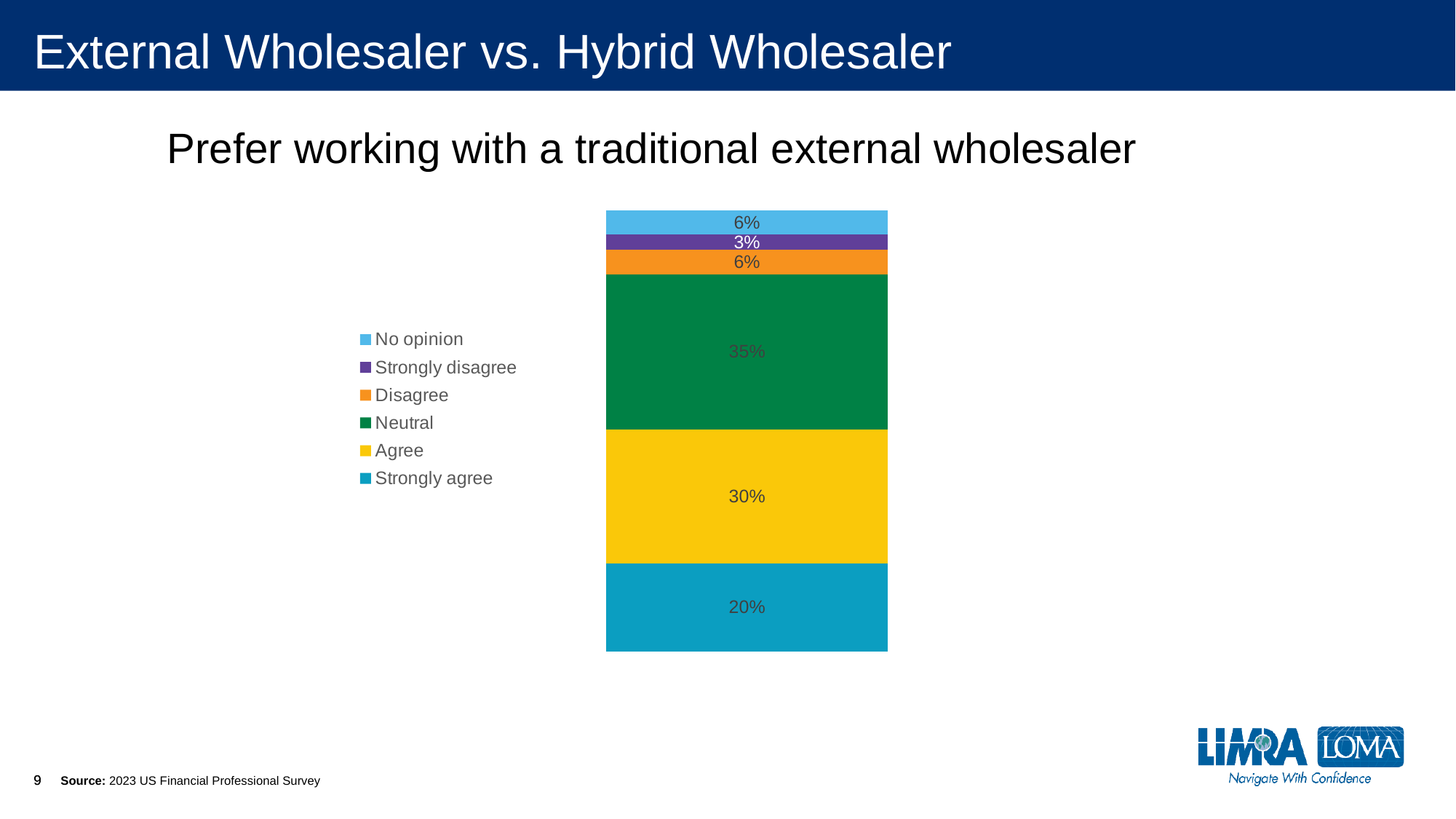
What is the combined percentage of respondents who Agree or Strongly agree? 50% How many response categories does the legend list? 6 Which response category has the largest share of respondents? Neutral What kind of chart is shown on the slide? Stacked bar chart What percentage of respondents Strongly disagree? 3% What percentage of respondents Strongly agree that they prefer working with a traditional external wholesaler? 20% Which is larger, the share for Agree or the share for Strongly agree? Agree Which response category has the smallest share of respondents? Strongly disagree What is the difference in percentage points between Neutral and Agree? 5 What colour is the Neutral segment of the bar? Green What percentage of respondents are Neutral about preferring to work with a traditional external wholesaler? 35% What percentage of respondents Agree? 30%